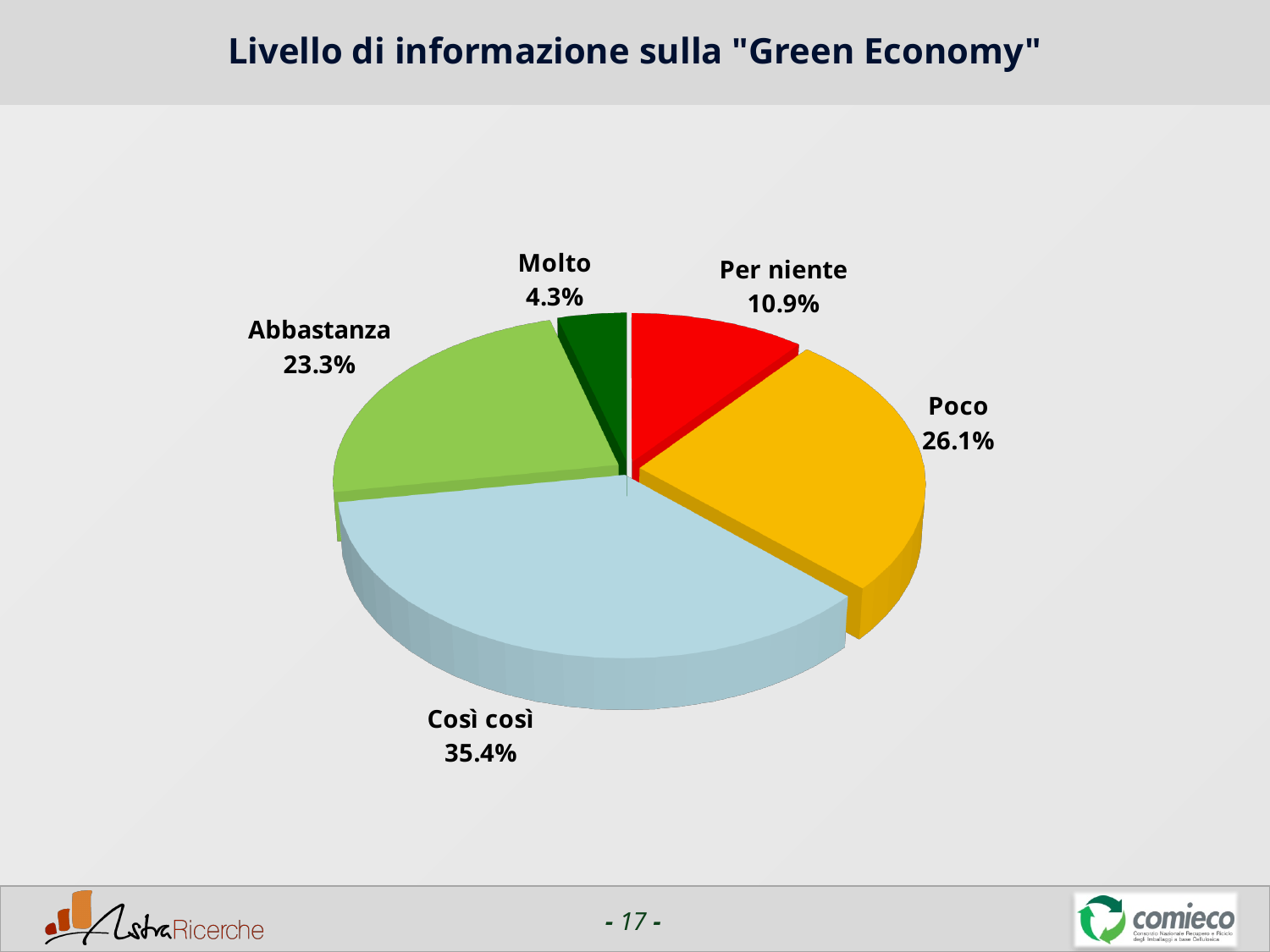
What is the value for "Molto"? 4.3% What is the value for "Così così"? 35.4% How many categories are shown in the pie chart? 5 What is the value for "Per niente"? 10.9% What is the difference between the values for "Poco" and "Abbastanza"? 2.8% Which category has the largest share? Così così What type of chart is shown on the slide? Pie chart What is the value for "Poco"? 26.1% Which is larger, the value for "Per niente" or the value for "Molto"? Per niente What is the value for "Abbastanza"? 23.3% Which category has the smallest share? Molto What is the title of the chart? Livello di informazione sulla "Green Economy"